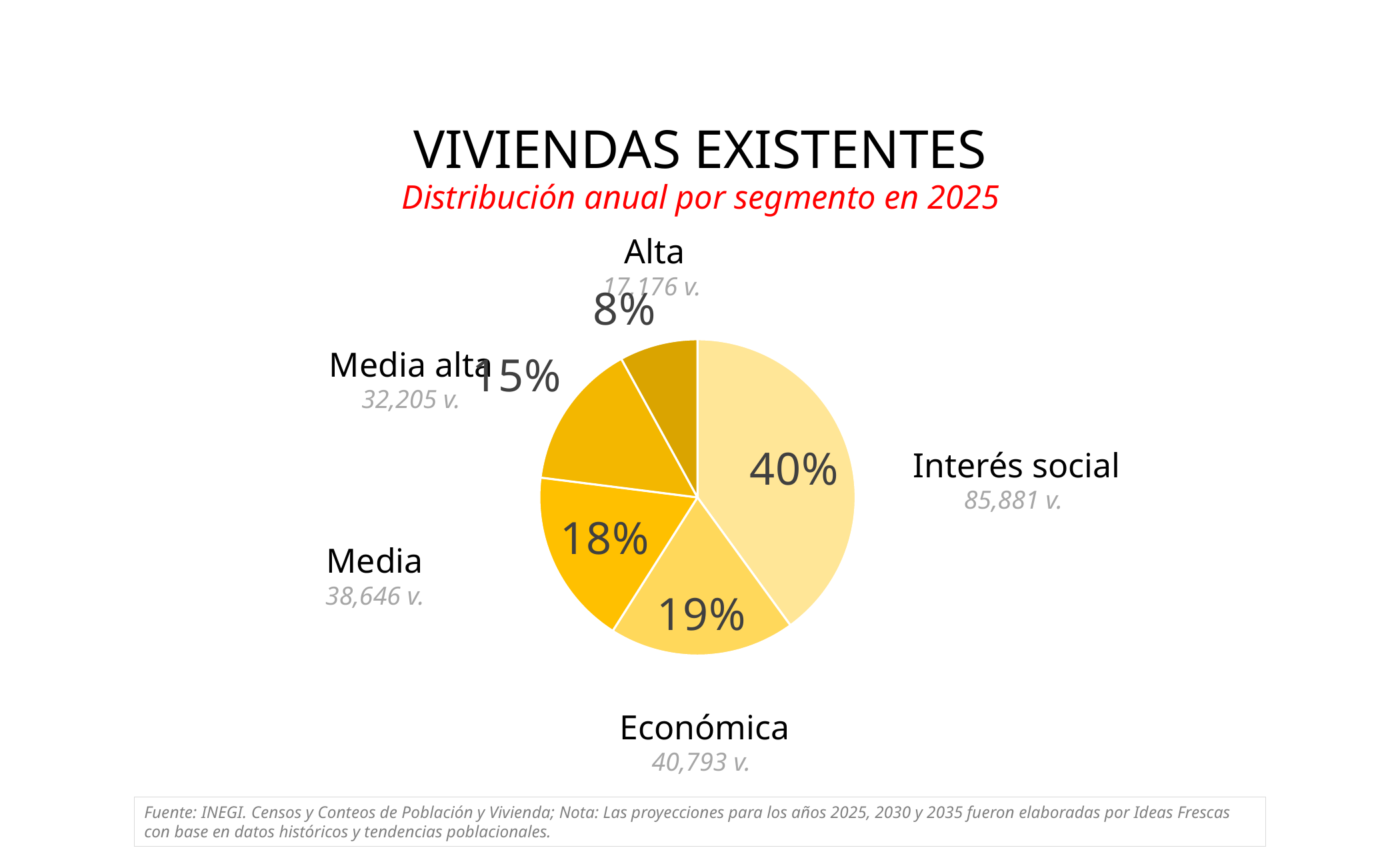
How many viviendas are shown for Económica? 40,793 v. How many viviendas are shown for Media alta? 32,205 v. How many viviendas are shown for Interés social? 85,881 v. Which segment has the largest share of the pie? Interés social What kind of chart is shown on the slide? Pie chart What share of the pie does Alta represent? 8% What share of the pie does Interés social represent? 40% What is the difference in percentage points between the Económica and Media shares? 1% Which segment has the smallest share of the pie? Alta How many segments does the pie chart have? 5 What is the subtitle shown in red below the chart title? Distribución anual por segmento en 2025 Which has the larger share, Media alta or Alta? Media alta